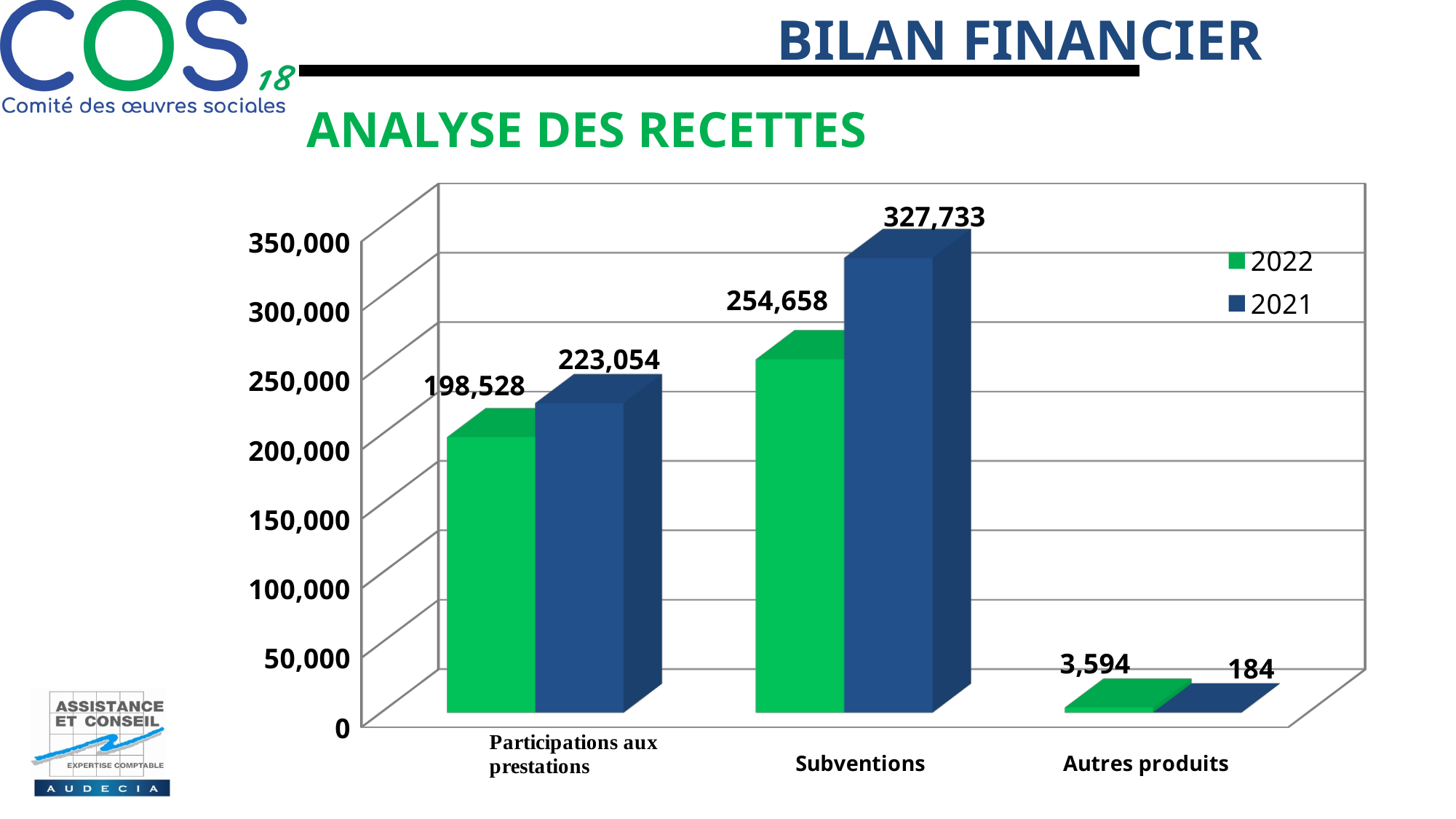
Which category has the lowest value in the 2021 series? Autres produits What is the difference between the 2021 and 2022 values for Participations aux prestations? 24,526 Is the 2022 value for Subventions greater or less than 300,000? less What is the value for Subventions in 2021? 327,733 How many categories are shown on the x axis? 3 How many series does the legend list? 2 Which category has the highest value in the 2022 series? Subventions What is the value for Participations aux prestations in 2022? 198,528 What kind of chart is shown on the slide? bar chart For Autres produits, which year has the larger value, 2022 or 2021? 2022 What is the difference between the 2021 and 2022 values for Subventions? 73,075 What is the value for Autres produits in 2021? 184